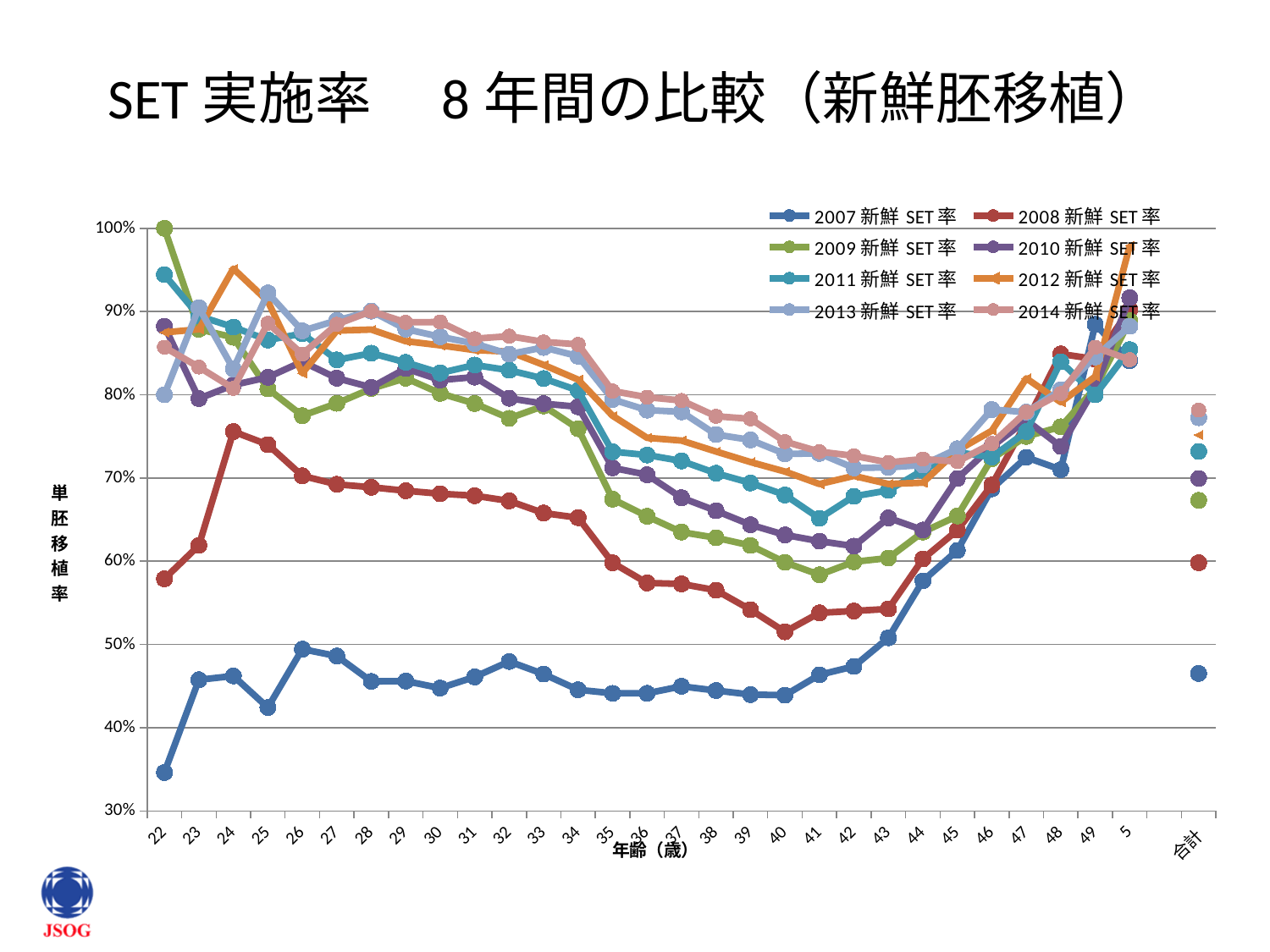
Is the 合計 value for 2007 新鮮 SET 率 greater or less than 50%? less Is the value for 2009 新鮮 SET 率 at age 22 greater or less than 90%? greater At age 30, which is larger: 2007 新鮮 SET 率 or 2008 新鮮 SET 率? 2008 新鮮 SET 率 Is the value for 2007 新鮮 SET 率 at age 22 greater or less than 40%? less Which series has the lowest value at age 22? 2007 新鮮 SET 率 Which series has the highest value at age 22? 2009 新鮮 SET 率 Does the 2008 新鮮 SET 率 series rise or fall from age 24 to age 40? fall How many series does the legend list? 8 What is the label of the x axis? 年齢（歳） Does the 2007 新鮮 SET 率 series rise or fall from age 43 to age 49? rise What kind of chart is shown on the slide? line chart